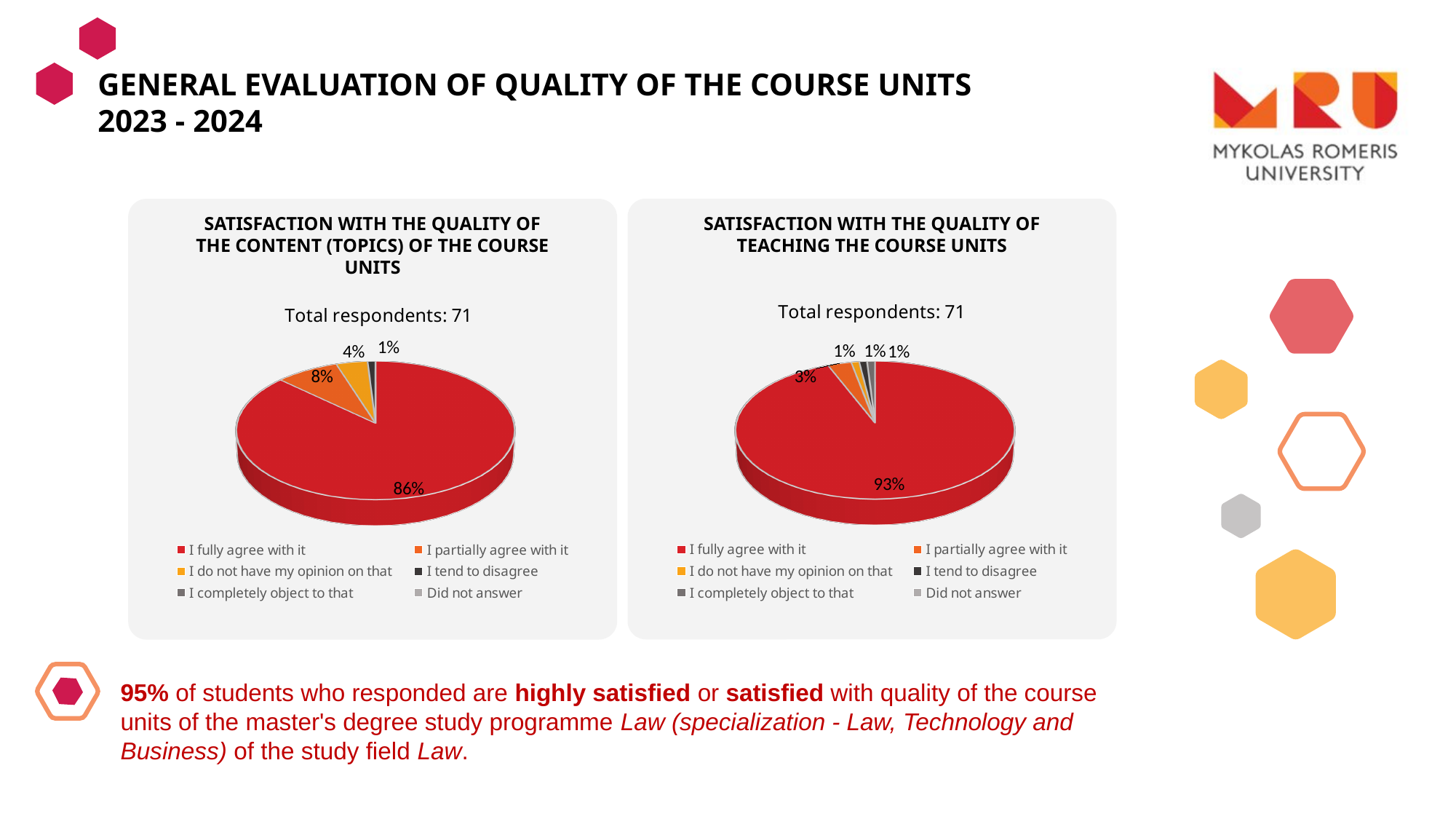
In the chart titled 'Satisfaction with the quality of the content (topics) of the course units', what share of respondents chose 'I partially agree with it'? 8% How many total respondents are reported for the 'Satisfaction with the quality of teaching the course units' chart? 71 In the chart titled 'Satisfaction with the quality of teaching the course units', what share of respondents chose 'I fully agree with it'? 93% In the chart titled 'Satisfaction with the quality of the content (topics) of the course units', which response has the largest slice? I fully agree with it How many entries does the legend of the 'Satisfaction with the quality of the content (topics) of the course units' chart list? 6 In the chart titled 'Satisfaction with the quality of the content (topics) of the course units', what share of respondents chose 'I fully agree with it'? 86% What is the difference between the 'I fully agree with it' share in the teaching quality chart and the 'I fully agree with it' share in the content quality chart? 7% Which chart has the larger 'I partially agree with it' share: the content quality chart or the teaching quality chart? The content quality chart In the chart titled 'Satisfaction with the quality of teaching the course units', what share of respondents chose 'I partially agree with it'? 3% What type of chart is used in the 'Satisfaction with the quality of teaching the course units' panel? Pie chart In the chart titled 'Satisfaction with the quality of teaching the course units', which response has the largest slice? I fully agree with it In the chart titled 'Satisfaction with the quality of the content (topics) of the course units', what share of respondents chose 'I do not have my opinion on that'? 4%